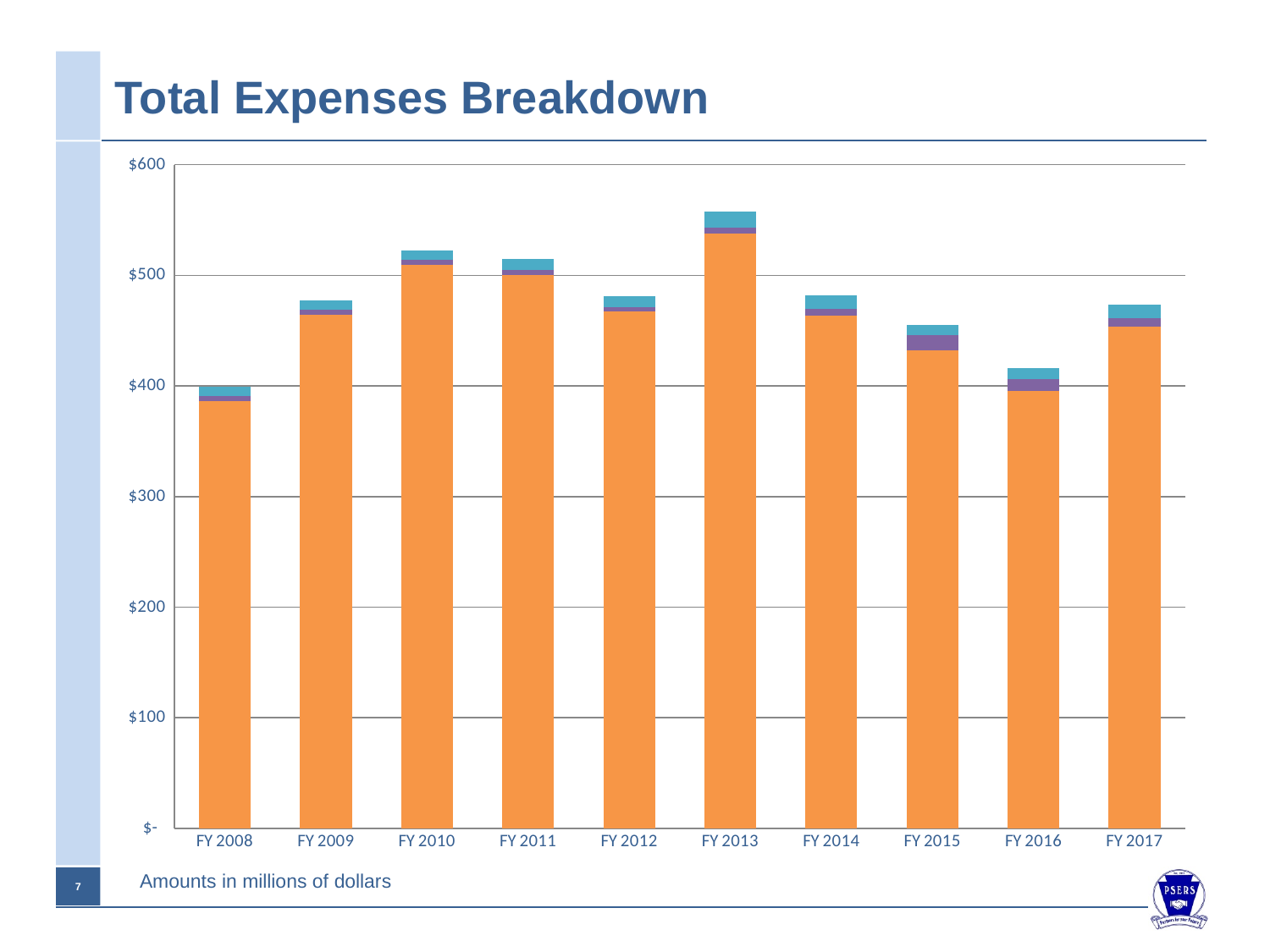
Do the totals rise or fall from FY 2013 to FY 2016? fall Is the total for FY 2016 greater or less than $500? less Is the total for FY 2015 greater or less than $400? greater What is the title of the chart on the slide? Total Expenses Breakdown Which is larger, the total for FY 2010 or the total for FY 2008? FY 2010 What kind of chart is shown on the slide? Stacked bar chart How many fiscal years are shown on the x axis of the chart? 10 Is the total for FY 2008 greater or less than $500? less Which is larger, the total for FY 2013 or the total for FY 2016? FY 2013 Which fiscal year has the highest total expenses in the chart? FY 2013